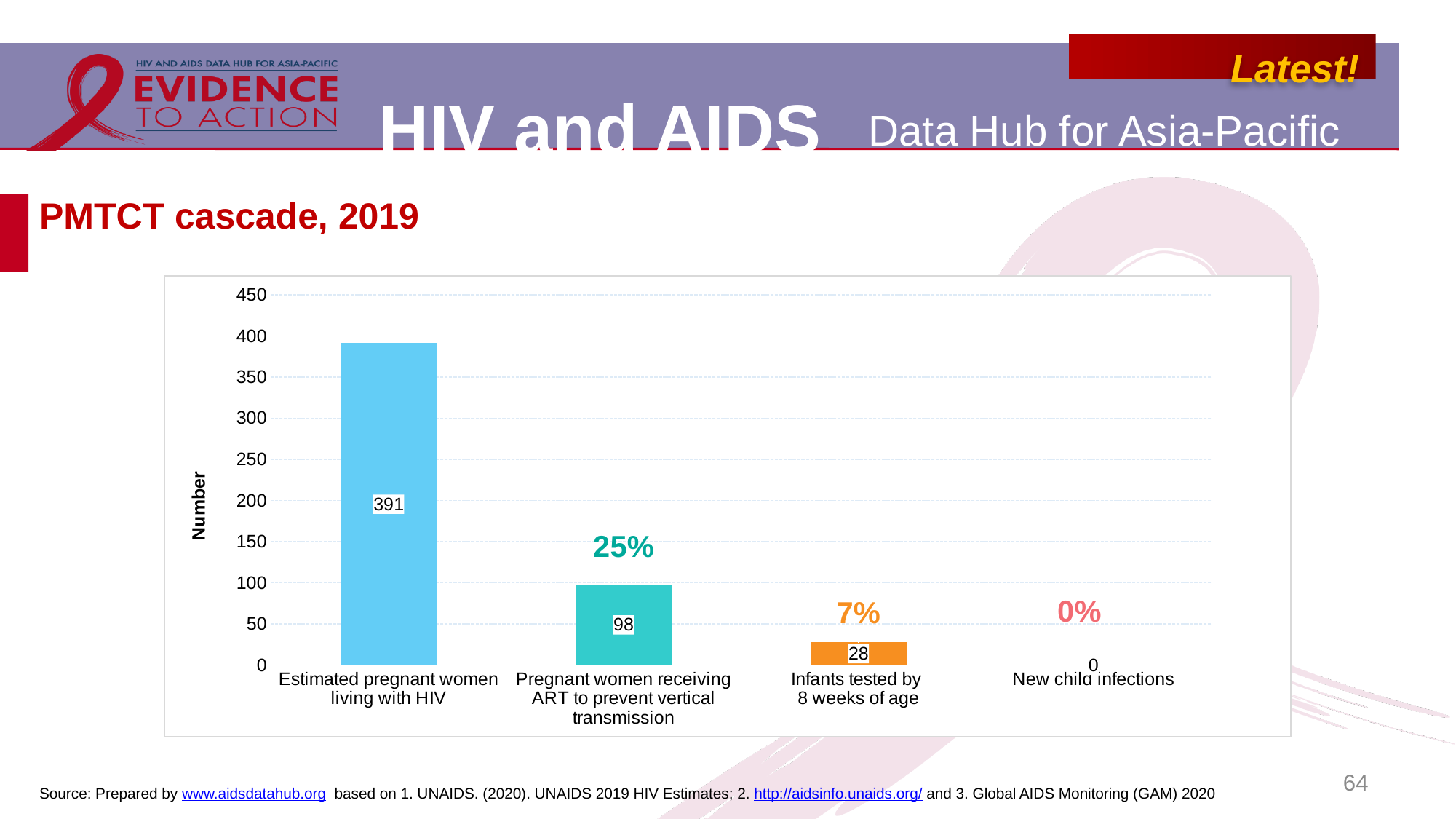
What percentage is shown above the bar for Infants tested by 8 weeks of age? 7% Which category has the highest value? Estimated pregnant women living with HIV Which category has the lowest value? New child infections Which is larger: Pregnant women receiving ART to prevent vertical transmission or Infants tested by 8 weeks of age? Pregnant women receiving ART to prevent vertical transmission What is the value for Infants tested by 8 weeks of age? 28 What is the value for Pregnant women receiving ART to prevent vertical transmission? 98 How many categories are shown on the x axis? 4 What is the value for Estimated pregnant women living with HIV? 391 What is the value for New child infections? 0 What kind of chart is shown on the slide? Bar chart What is the difference between Estimated pregnant women living with HIV and Pregnant women receiving ART to prevent vertical transmission? 293 What percentage is shown above the bar for Pregnant women receiving ART to prevent vertical transmission? 25%